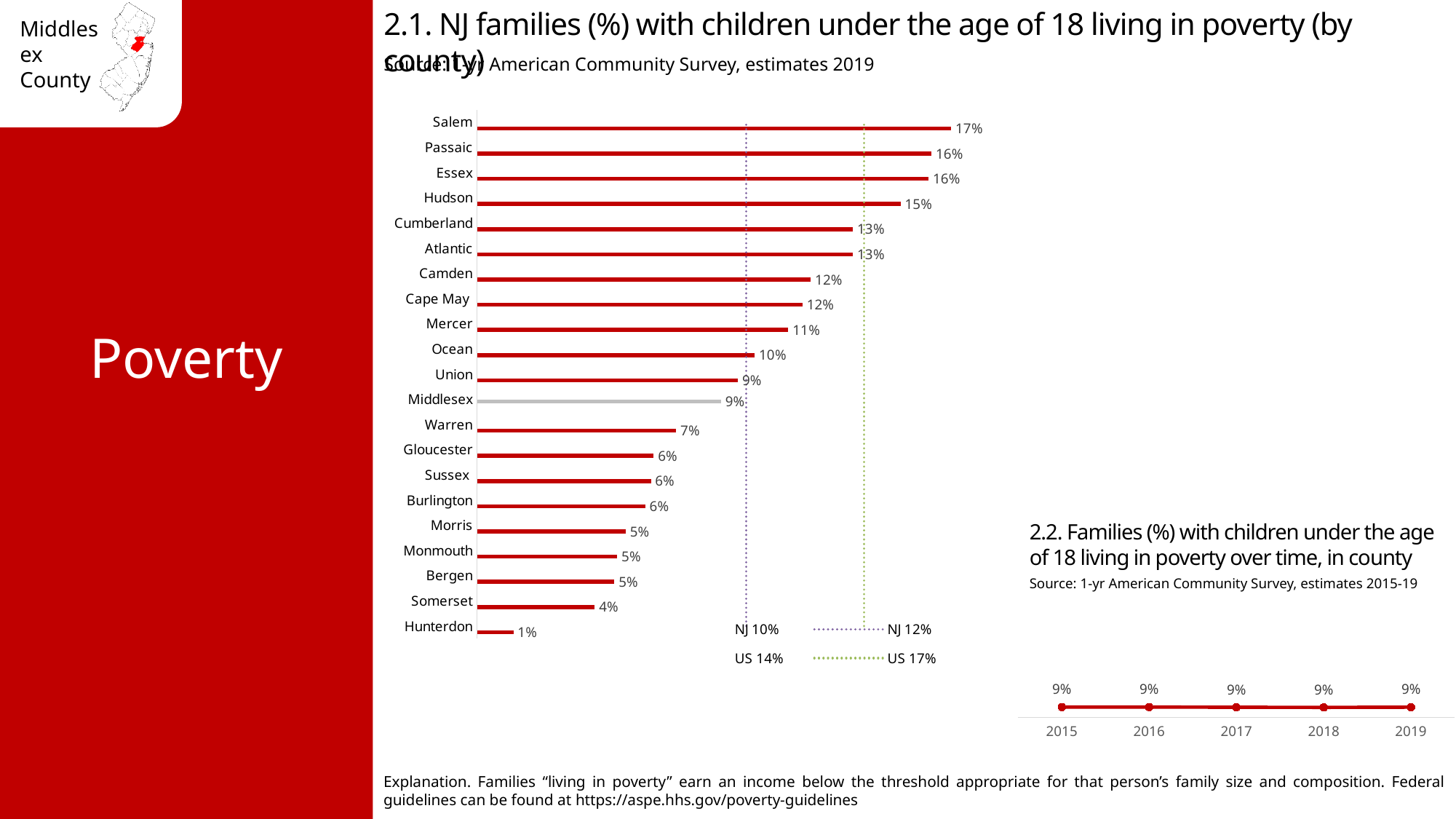
In chart 2.1, what is the value for Somerset? 4% In chart 2.1, which has a larger value, Hudson or Camden? Hudson In chart 2.1, how many counties are shown? 21 In chart 2.2, do the values rise, fall, or stay flat from 2015 to 2019? Stay flat In chart 2.1, which county has the lowest value? Hunterdon In chart 2.1, which county has the highest value? Salem In chart 2.2 (families in poverty over time, in county), what is the value for 2019? 9% In chart 2.1 (NJ families with children under 18 living in poverty by county), what is the value for Salem? 17% In chart 2.1, what is the value for Middlesex? 9% What kind of chart is chart 2.1? Bar chart In chart 2.1, which county's bar is shown in grey rather than red? Middlesex In chart 2.1, what is the difference between the values for Salem and Hunterdon? 16%